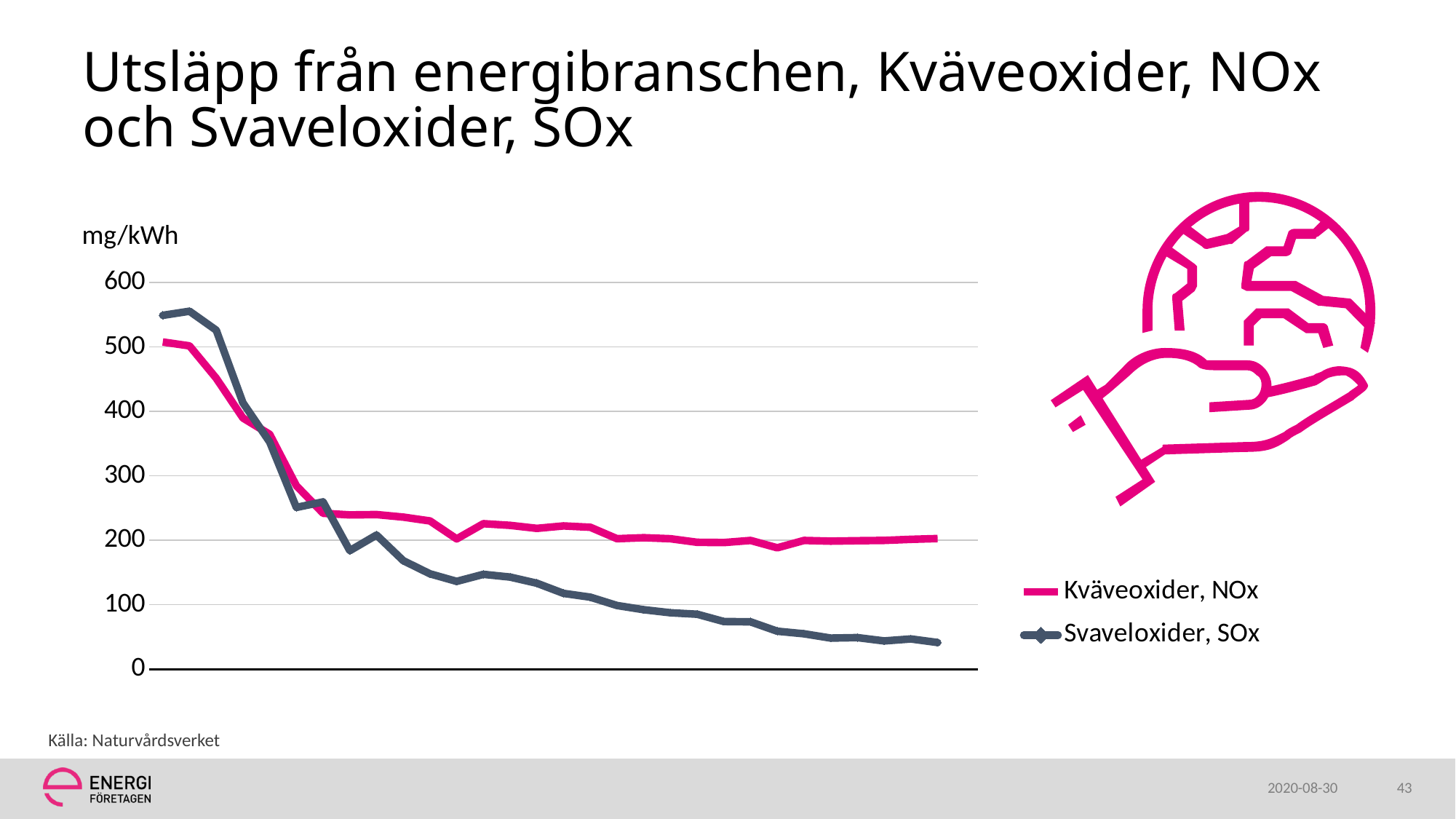
Do the values for Kväveoxider, NOx rise or fall overall along the x axis? fall At the start of the series, which is larger: Kväveoxider, NOx or Svaveloxider, SOx? Svaveloxider, SOx Is the last value for Kväveoxider, NOx greater or less than 100? greater At the end of the series, which is larger: Kväveoxider, NOx or Svaveloxider, SOx? Kväveoxider, NOx Is the last value for Kväveoxider, NOx greater or less than 300? less Is the last value for Svaveloxider, SOx greater or less than 100? less Do the values for Svaveloxider, SOx rise or fall along the x axis? fall Which two series are listed in the legend? Kväveoxider, NOx and Svaveloxider, SOx What unit is shown on the y axis of the chart? mg/kWh How many series does the legend list? 2 What kind of chart is shown on the slide? line chart